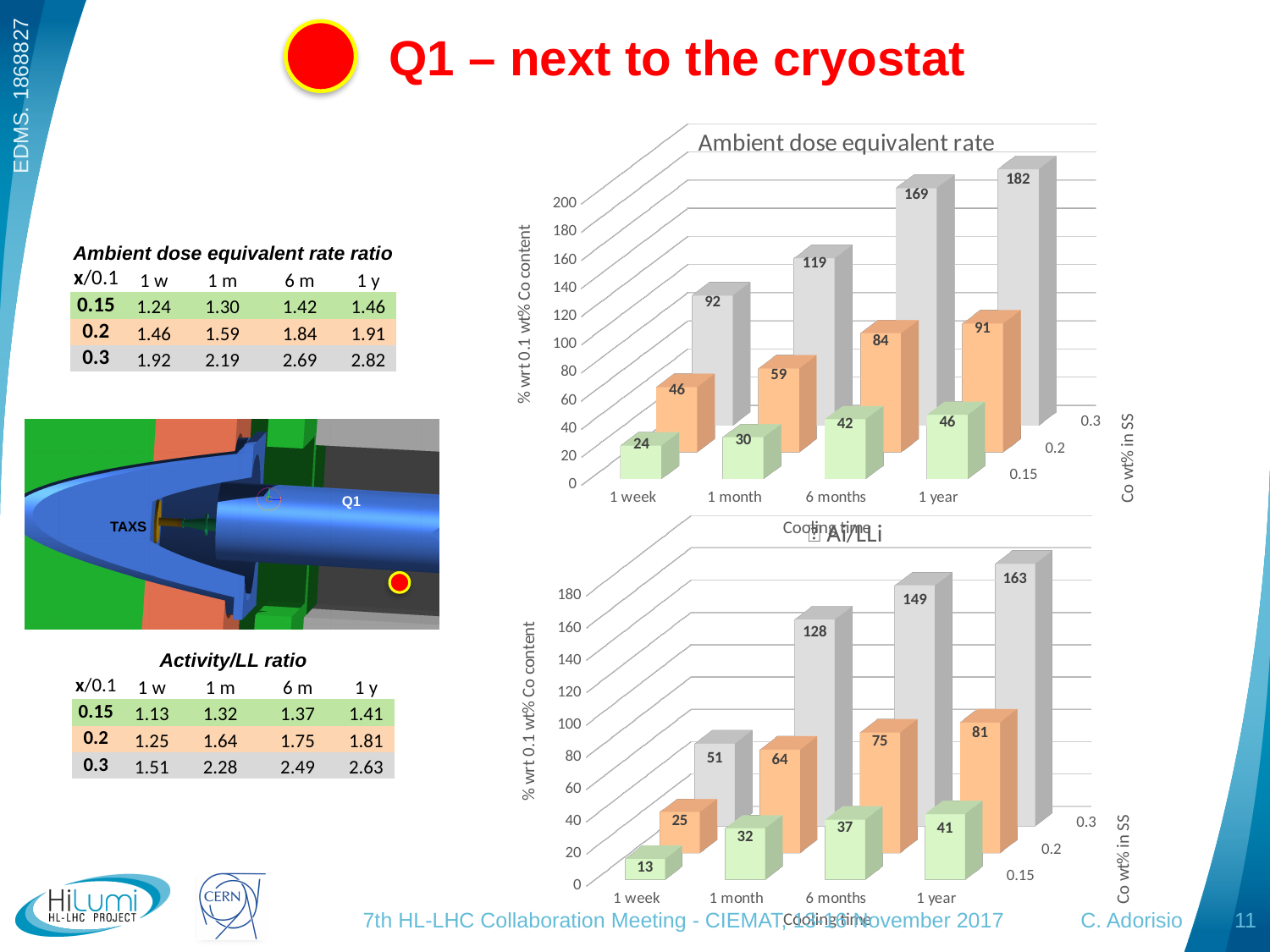
In the bottom chart, what is the value for 1 week at 0.15 Co wt% in SS? 13 In the 'Ambient dose equivalent rate' chart, what is the value for 1 week at 0.15 Co wt% in SS? 24 What kind of chart is the 'Ambient dose equivalent rate' chart? bar chart In the 'Ambient dose equivalent rate' chart, what is the value for 6 months at 0.2 Co wt% in SS? 84 In the 'Ambient dose equivalent rate' chart, which cooling time has the highest value for the 0.3 Co wt% series? 1 year In the bottom chart, do the values for the 0.3 Co wt% series rise or fall as cooling time increases from 1 week to 1 year? rise In the 'Ambient dose equivalent rate' chart, what is the difference between the 1 year and 1 week values at 0.3 Co wt% in SS? 90 In the bottom chart, which cooling time has the lowest value for the 0.2 Co wt% series? 1 week In the 'Ambient dose equivalent rate' chart, how many cooling-time categories are shown on the x axis? 4 In the bottom chart, what is the value for 1 month at 0.3 Co wt% in SS? 128 In the 'Ambient dose equivalent rate' chart, what is the value for 1 year at 0.3 Co wt% in SS? 182 In the bottom chart, is the value for 1 year at 0.2 Co wt% larger or smaller than the value for 6 months at 0.2 Co wt%? larger